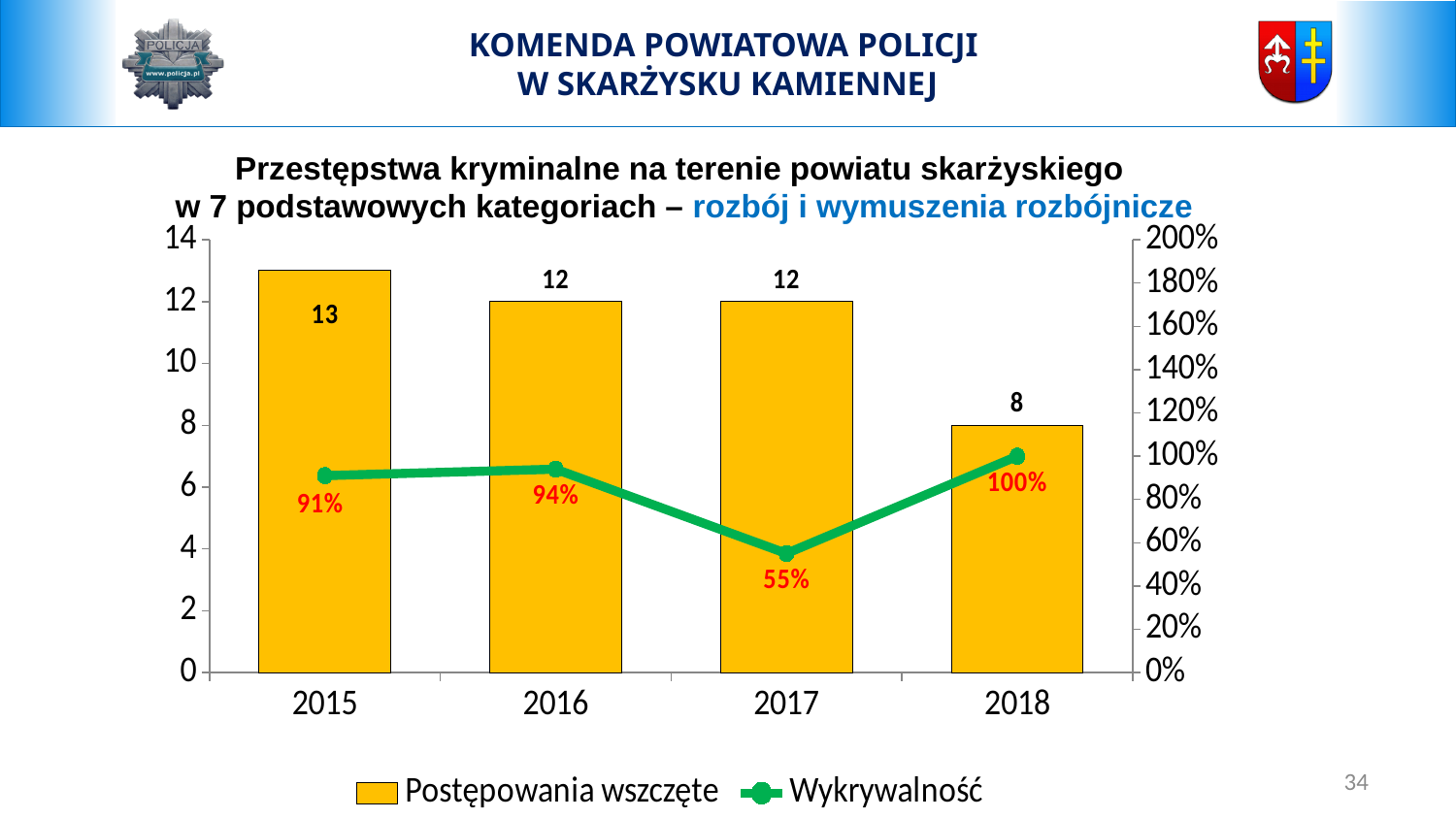
Which year has the lowest Wykrywalność? 2017 What is the Wykrywalność value for 2017? 55% Which year has the lowest value of Postępowania wszczęte? 2018 Which is larger, Wykrywalność in 2015 or in 2016? 2016 What is the difference between Postępowania wszczęte in 2015 and 2018? 5 How many series does the legend list? 2 Does the value of Postępowania wszczęte rise or fall from 2015 to 2018? fall What colour are the bars for Postępowania wszczęte? yellow How many years are shown on the x axis? 4 Which year has the highest Wykrywalność? 2018 What is the Wykrywalność value for 2018? 100% What is the value of Postępowania wszczęte for 2015? 13